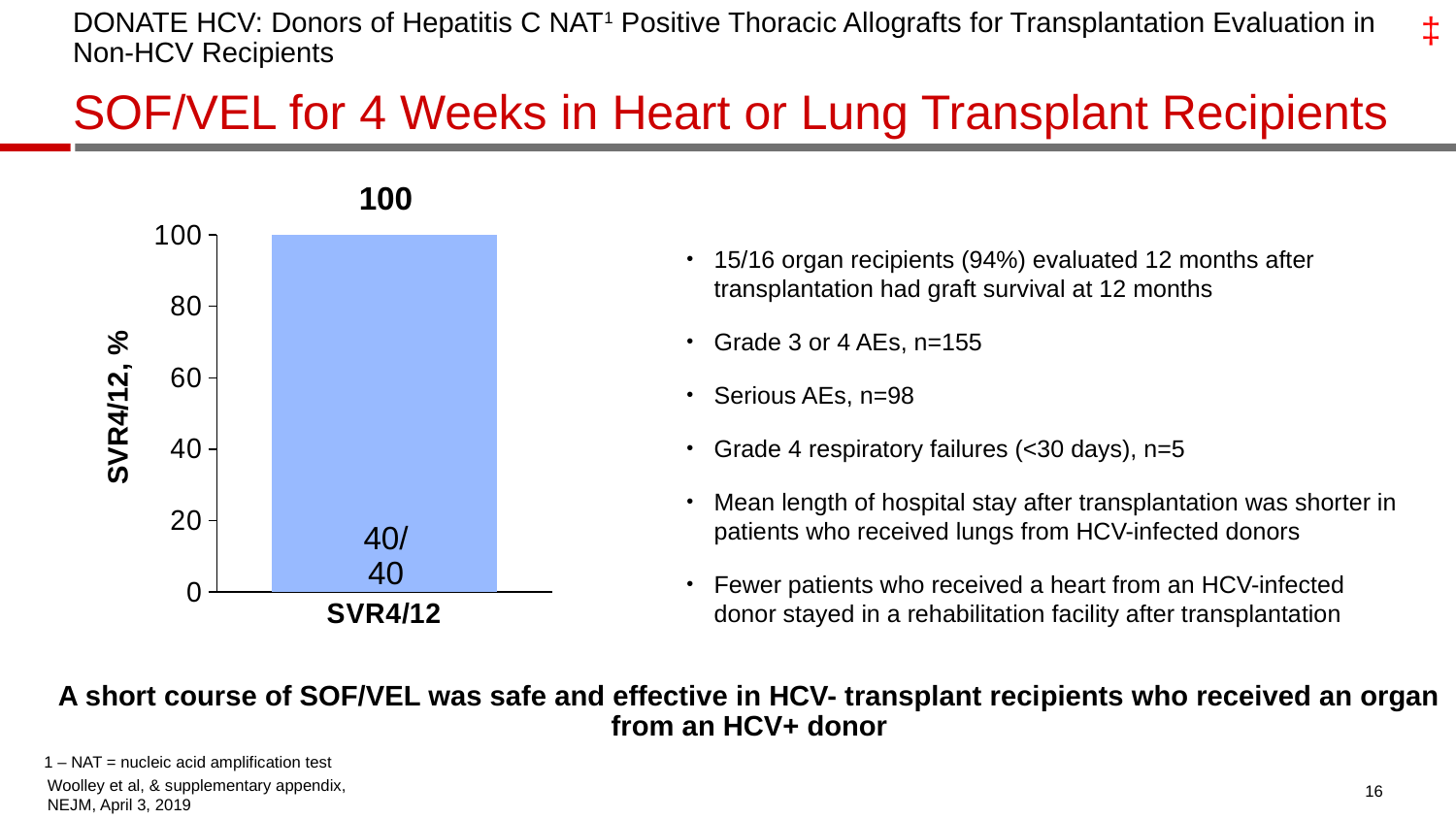
Does the SVR4/12 bar reach the top tick of the y-axis? Yes What is the label on the y-axis of the chart? SVR4/12, % What is the SVR4/12 value shown on the bar chart? 100 What fraction of patients is printed inside the SVR4/12 bar? 40/40 What kind of chart is shown on the slide? bar chart Is the value for SVR4/12 greater or less than 80? greater What is the highest tick value shown on the y-axis of the chart? 100 What is the category label under the bar on the x-axis? SVR4/12 How many bars does the chart show? 1 How many patients achieved SVR4/12 according to the label inside the bar? 40